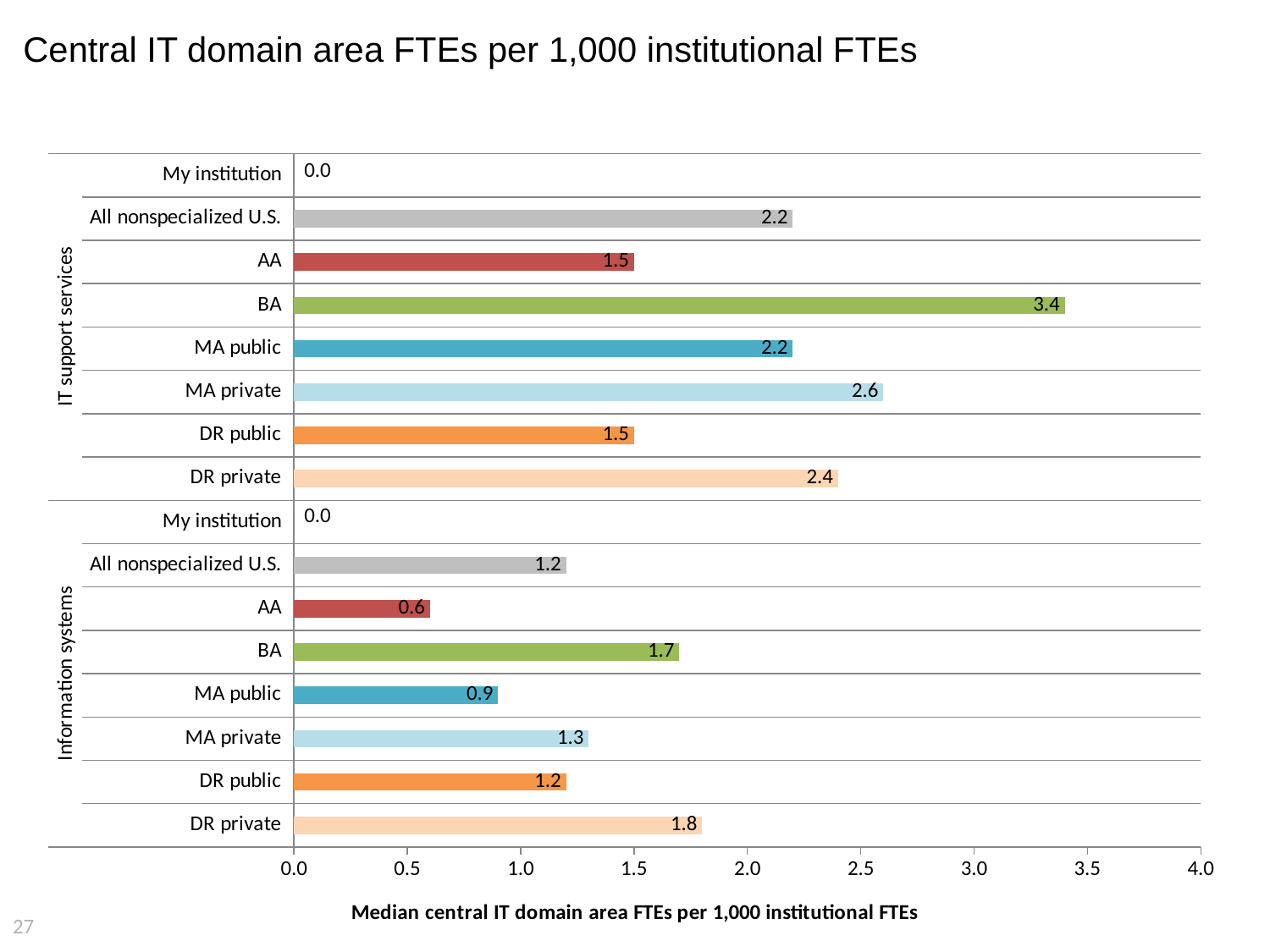
How many bars (categories) are plotted in total across both groups? 16 Which category has the highest value in the Information systems group? DR private What is the difference between the BA value under IT support services and the BA value under Information systems? 1.7 What kind of chart is shown on the slide? Bar chart Which category has the highest value in the IT support services group? BA What is the value for BA under IT support services? 3.4 What is the value for All nonspecialized U.S. under Information systems? 1.2 Is the value for BA under IT support services greater or less than 3.0? greater What is the difference between MA private and DR private under IT support services? 0.2 Which category has the lowest nonzero value in the Information systems group? AA What is the value for DR private under Information systems? 1.8 Under Information systems, which is larger: MA public or MA private? MA private